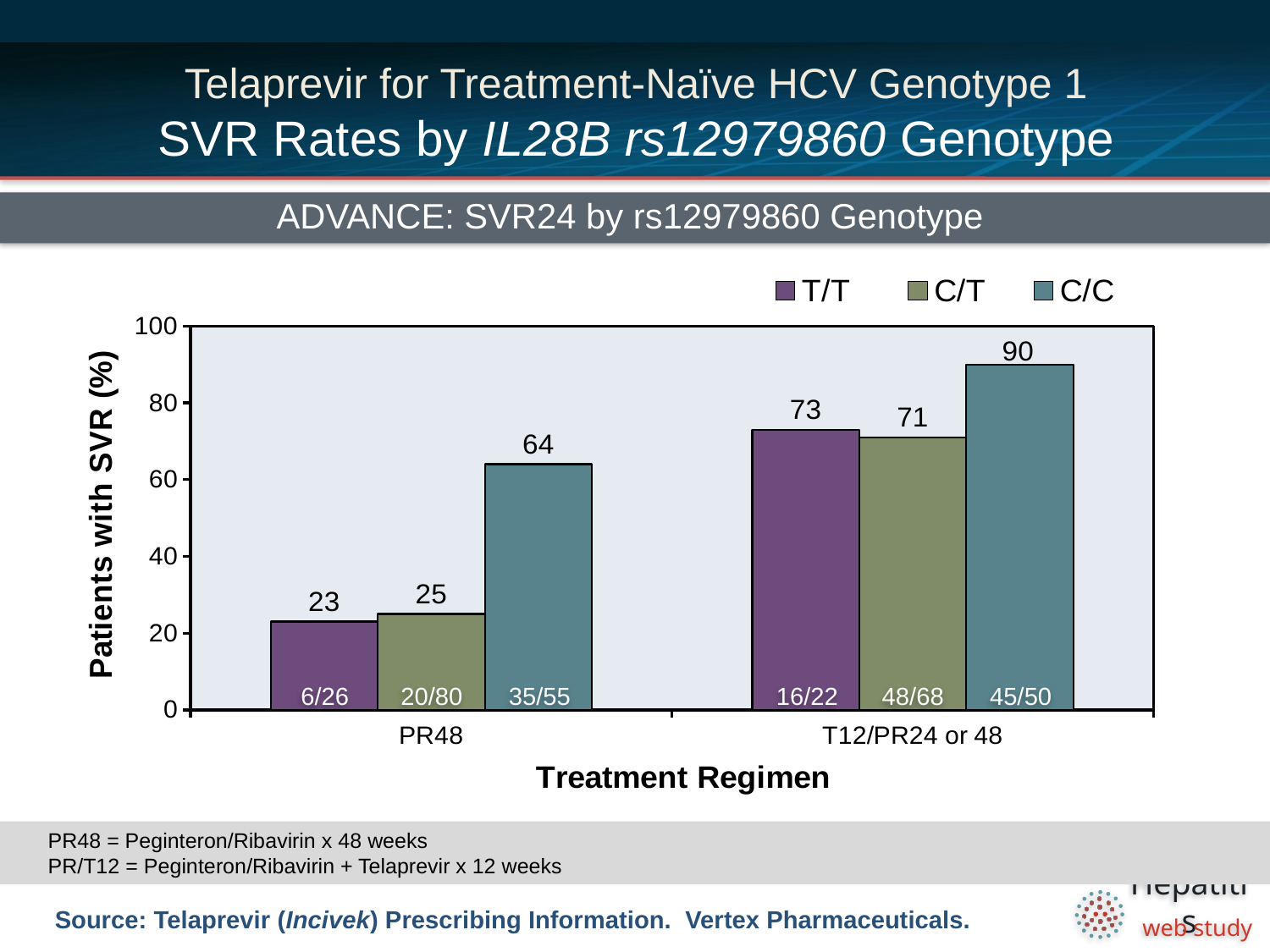
Which genotype has the highest SVR rate in the T12/PR24 or 48 group? C/C What is the SVR rate for the C/T genotype in the PR48 group? 25 Which genotype has the lowest SVR rate in the PR48 group? T/T What is the label of the y axis? Patients with SVR (%) What is the patient fraction shown inside the C/T bar for the T12/PR24 or 48 group? 48/68 Which is larger: the SVR rate for T/T in the T12/PR24 or 48 group or the SVR rate for C/T in the PR48 group? T/T in the T12/PR24 or 48 group What is the difference in SVR rate between the C/C genotype in the T12/PR24 or 48 group and the C/C genotype in the PR48 group? 26 What kind of chart is shown on the slide? Bar chart What is the SVR rate for the C/C genotype in the PR48 group? 64 What is the SVR rate for the T/T genotype in the T12/PR24 or 48 group? 73 How many series does the legend list? 3 How many treatment regimen categories are shown on the x axis? 2